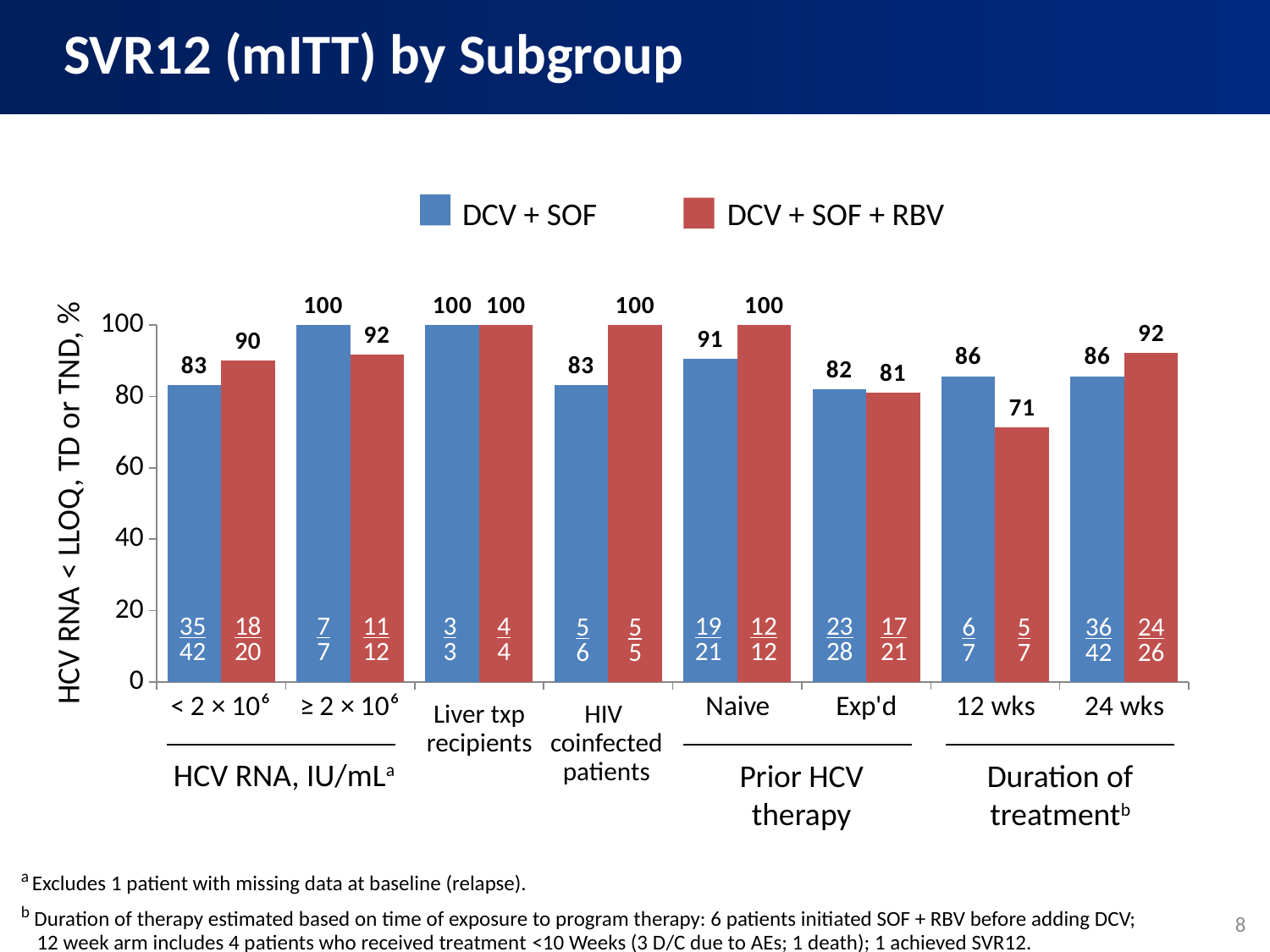
Which category has the lowest value for the DCV + SOF series? Exp'd In the 24 wks category, which series has the higher value, DCV + SOF or DCV + SOF + RBV? DCV + SOF + RBV In the ≥ 2 × 10⁶ category, which series has the higher value, DCV + SOF or DCV + SOF + RBV? DCV + SOF What kind of chart is shown on the slide? Bar chart What is the SVR12 value for the DCV + SOF series in the 12 wks category? 86 What is the label of the y axis? HCV RNA < LLOQ, TD or TND, % What is the SVR12 value for the DCV + SOF series in the HIV coinfected patients category? 83 How many subgroup categories are shown on the x axis? 8 What is the SVR12 value for the DCV + SOF + RBV series in the Naive category? 100 Which category has the lowest value for the DCV + SOF + RBV series? 12 wks How many series does the legend list? 2 What is the difference between the DCV + SOF and DCV + SOF + RBV values in the 12 wks category? 15